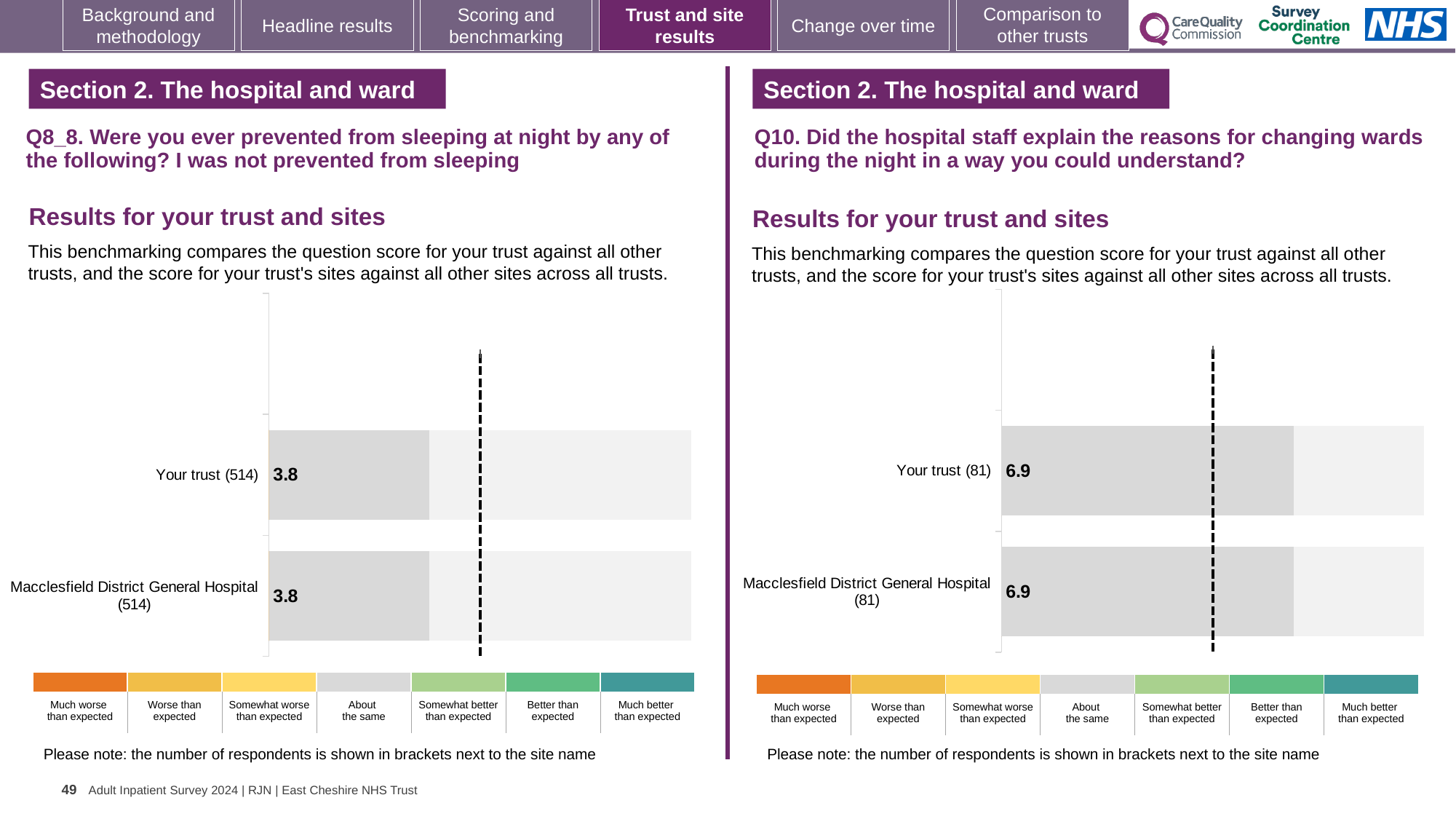
In the right chart (Q10), what is the value for Macclesfield District General Hospital? 6.9 In the right chart (Q10), what is the difference between the value for Your trust and the value for Macclesfield District General Hospital? 0 In the left chart (Q8_8), is the value for Your trust larger than, smaller than, or the same as the value for Macclesfield District General Hospital? the same In the left chart (Q8_8), how many respondents are shown in brackets for Your trust? 514 In the right chart (Q10), what is the value for Your trust? 6.9 How many bars are plotted in the left chart (Q8_8)? 2 In the right chart (Q10), how many respondents are shown in brackets for Macclesfield District General Hospital? 81 In the left chart (Q8_8), what is the value for Your trust? 3.8 How many bars are plotted in the right chart (Q10)? 2 In the left chart (Q8_8), what is the value for Macclesfield District General Hospital? 3.8 What kind of chart is used in the left chart (Q8_8)? bar chart How many categories does the colour key below the right chart (Q10) list? 7